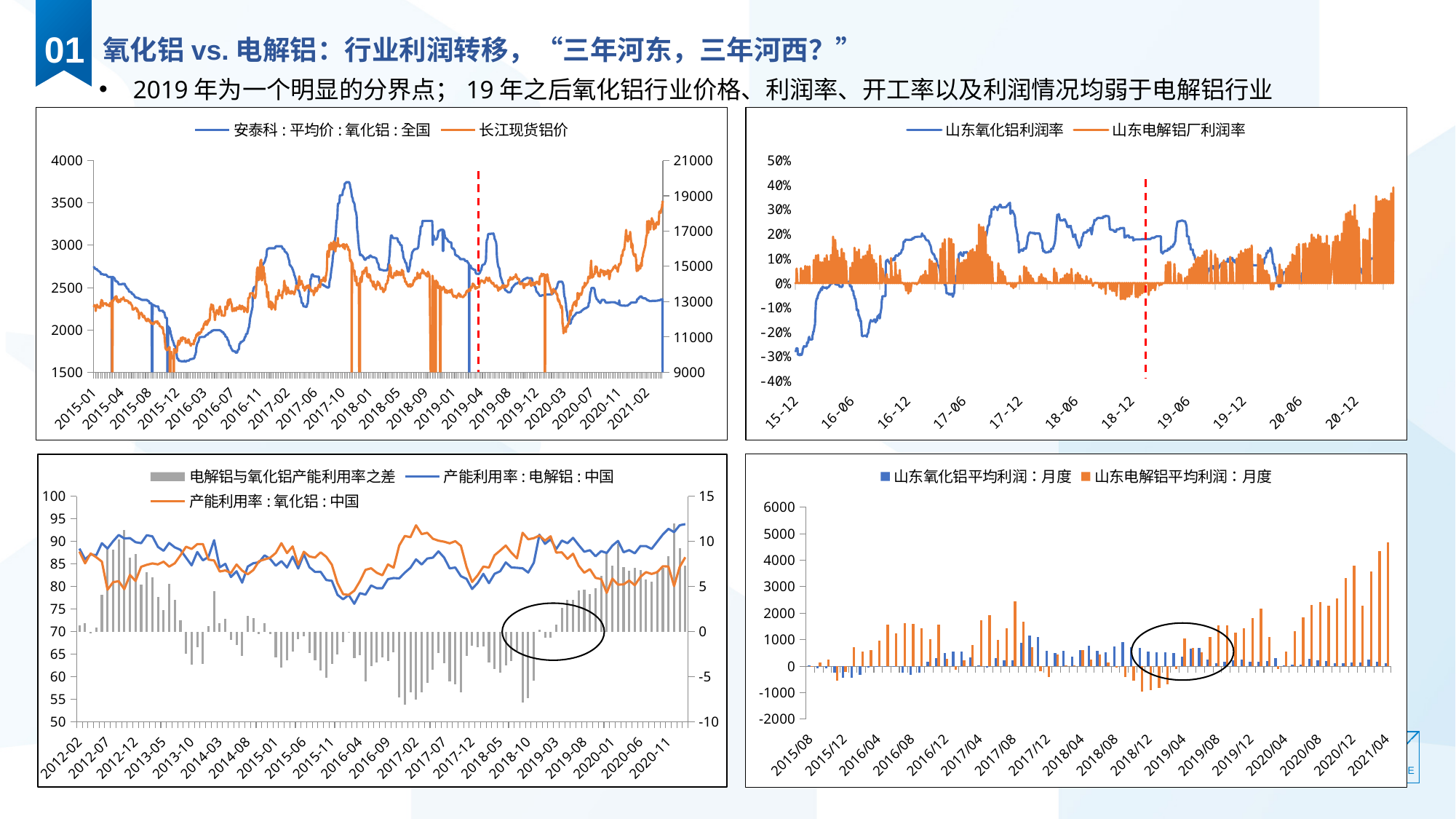
In the bottom-right chart, is the value of 山东氧化铝平均利润：月度 at 2021/04 greater or less than 1000? less In the top-left chart, is the value of 安泰科:平均价:氧化铝:全国 at 2015-12 greater or less than 2000? less In the top-right chart, is the value of 山东氧化铝利润率 at 15-12 greater or less than -20%? less In the bottom-left chart, what colour are the bars for 电解铝与氧化铝产能利用率之差? gray How many series does the legend of the bottom-left chart (产能利用率) list? 3 What type of chart is the bottom-right chart (山东氧化铝平均利润：月度 / 山东电解铝平均利润：月度)? bar chart How many series does the legend of the top-right chart (山东氧化铝利润率 / 山东电解铝厂利润率) list? 2 What type of chart is the top-left chart (安泰科:平均价:氧化铝:全国 / 长江现货铝价)? line chart In the bottom-left chart, does 产能利用率:电解铝:中国 rise or fall from 2020-01 to 2020-11? rise